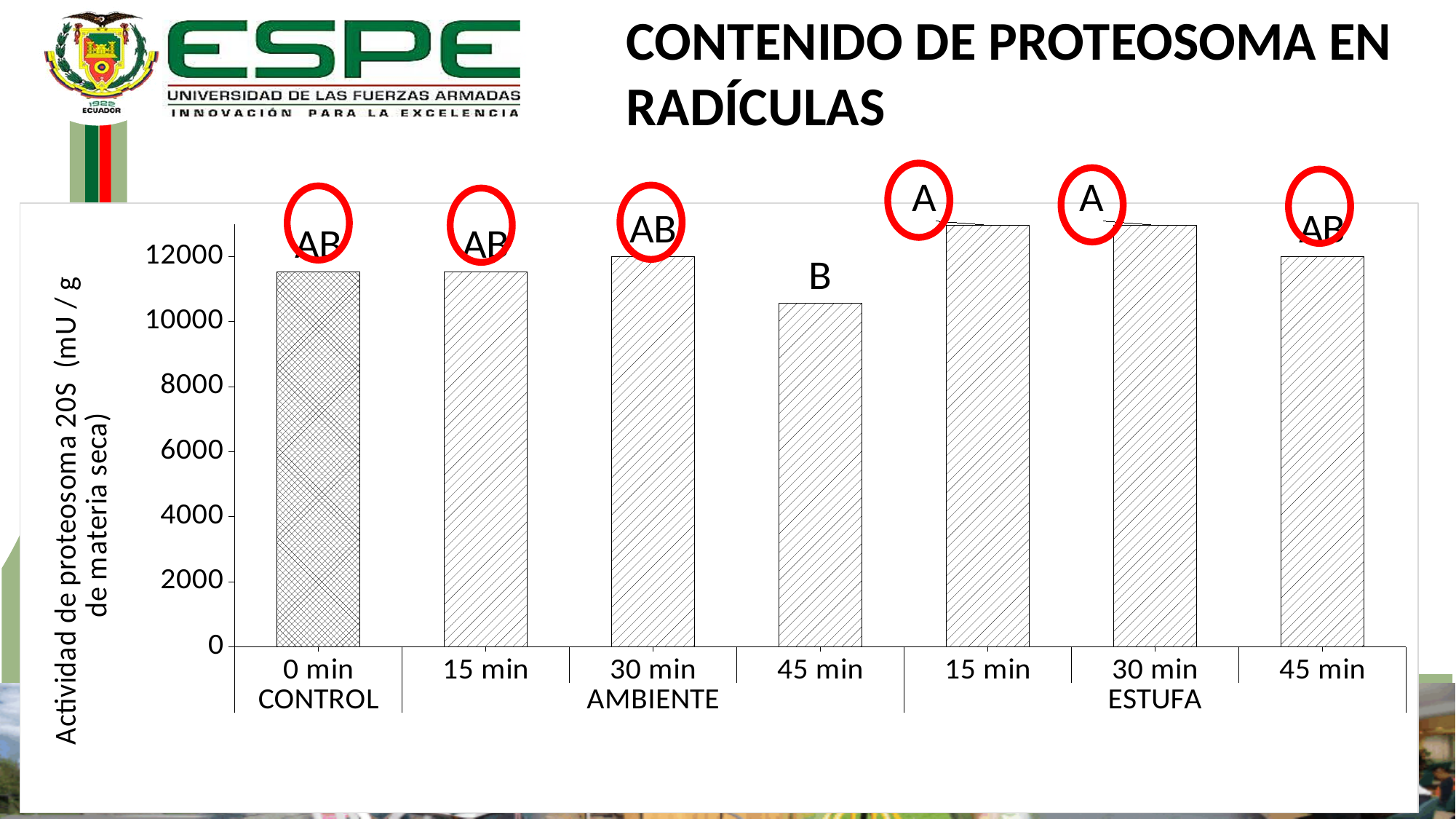
Which is larger, the value for 15 min ESTUFA or the value for 45 min AMBIENTE? 15 min ESTUFA What letter label is shown above the 45 min AMBIENTE bar? B Is the value for 0 min CONTROL greater or less than 12000? less How many bars are plotted in the chart? 7 Is the value for 45 min AMBIENTE greater or less than 12000? less Which is larger, the value for 0 min CONTROL or the value for 30 min ESTUFA? 30 min ESTUFA What kind of chart is shown on the slide? bar chart Which bar has the lowest value in the chart? 45 min AMBIENTE What is the title of the chart on the slide? CONTENIDO DE PROTEOSOMA EN RADÍCULAS Is the value for 45 min AMBIENTE greater or less than 10000? greater